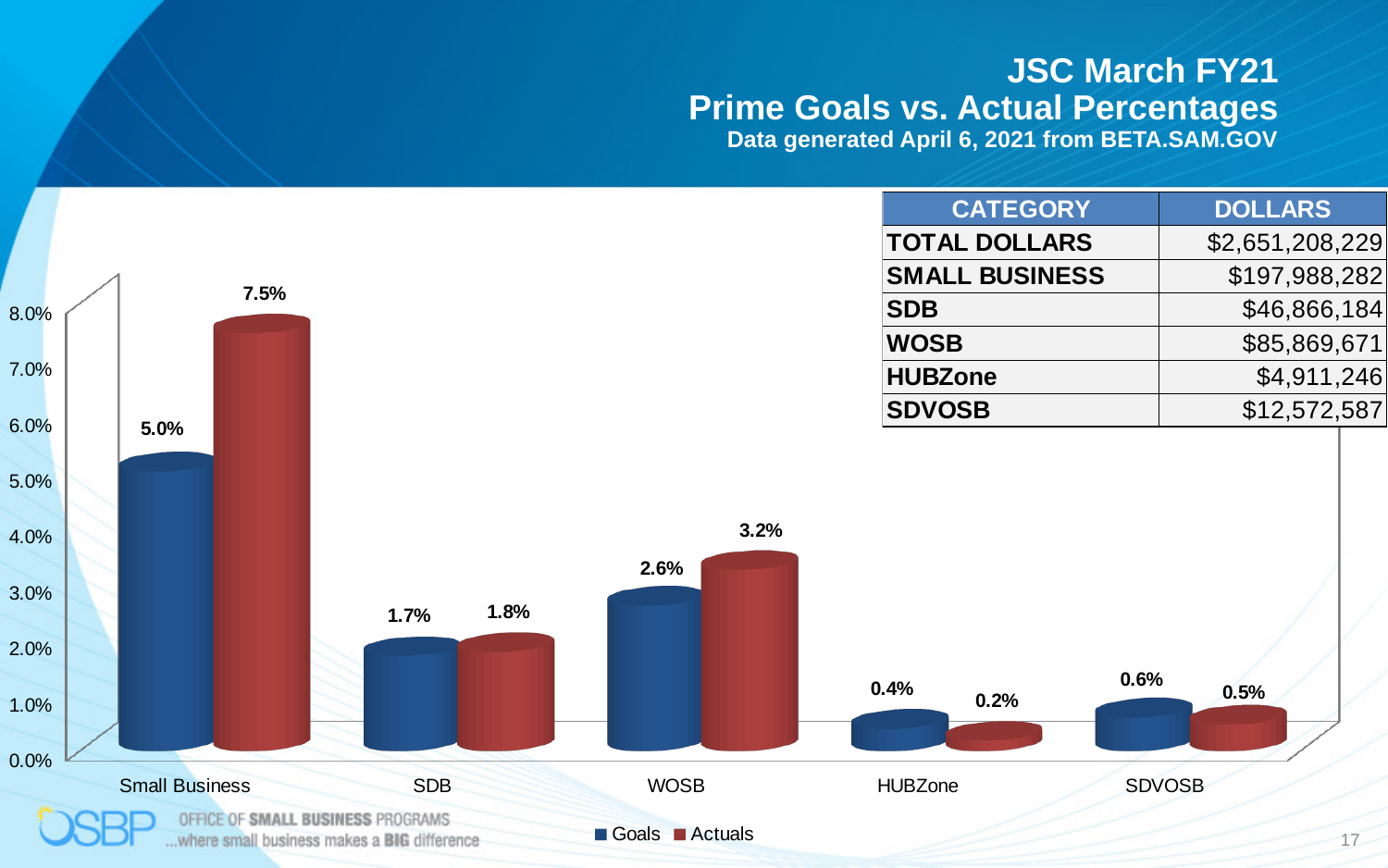
What is the Goals value for WOSB? 2.6% What are the two series named in the legend? Goals and Actuals How many series does the legend list? 2 How many categories are shown on the x axis? 5 Which category has the lowest Goals value? HUBZone What kind of chart is shown on the slide? Bar chart What is the difference between the Actuals and Goals values for Small Business? 2.5% What is the Goals value for SDVOSB? 0.6% Which is larger for SDVOSB, the Goals value or the Actuals value? Goals Which category has the highest Actuals value? Small Business What is the Actuals value for HUBZone? 0.2% What is the Actuals value for Small Business? 7.5%